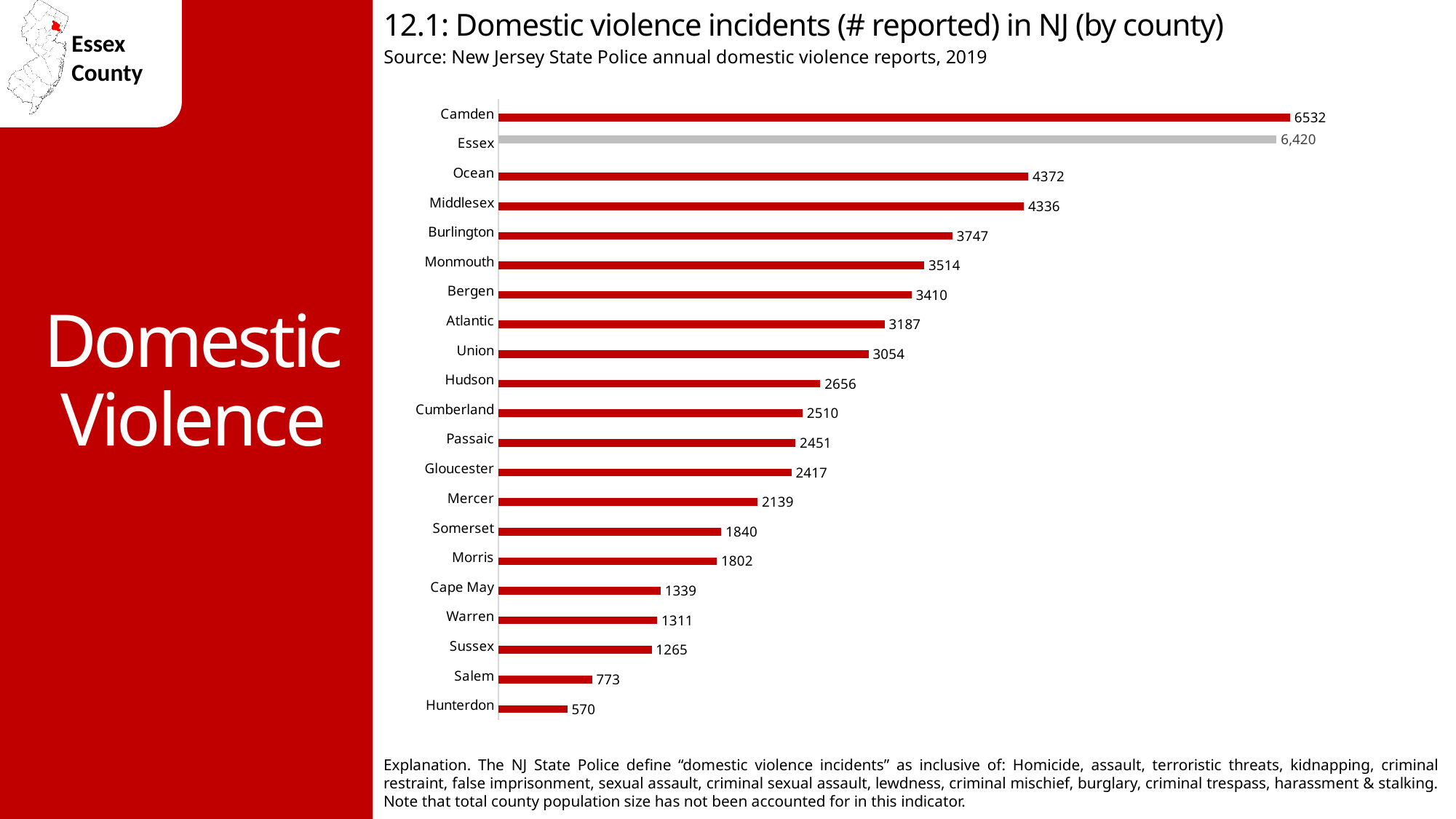
Which county has more reported incidents, Mercer or Somerset? Mercer Which county's bar is shown in grey rather than red? Essex Which county has the highest number of reported domestic violence incidents? Camden How many counties are shown in the chart? 21 What is the number of reported domestic violence incidents for Ocean County? 4372 What type of chart is used on this slide? Bar chart What is the difference between the number of incidents in Camden and Essex? 112 What is the difference between the number of incidents in Salem and Hunterdon? 203 What is the number of reported domestic violence incidents for Hunterdon County? 570 Which county has the lowest number of reported domestic violence incidents? Hunterdon What is the number of reported domestic violence incidents for Essex County? 6,420 Which county has more reported incidents, Bergen or Atlantic? Bergen